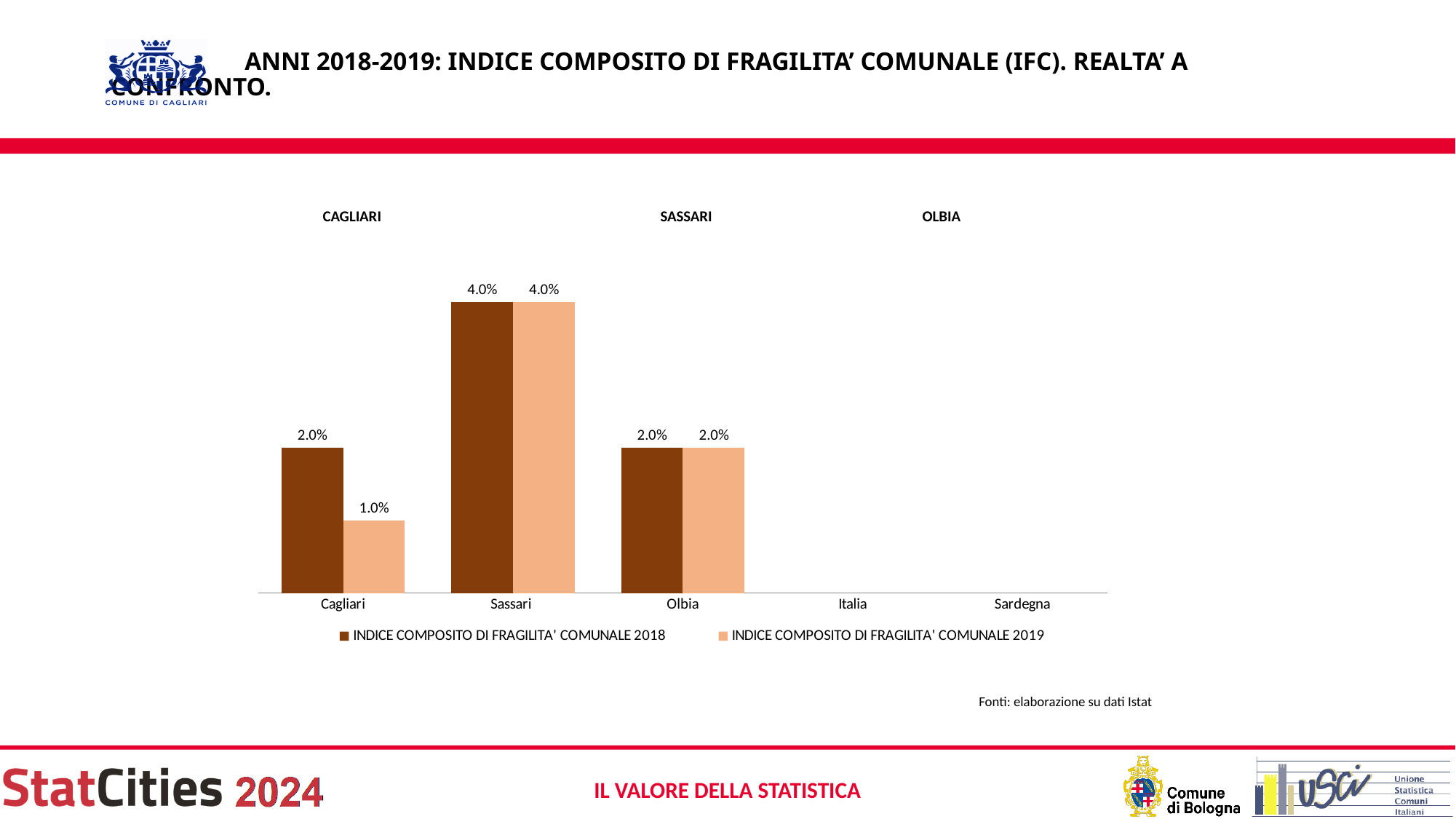
What is the value of INDICE COMPOSITO DI FRAGILITA' COMUNALE 2019 for Sassari? 4.0% What is the value of INDICE COMPOSITO DI FRAGILITA' COMUNALE 2018 for Cagliari? 2.0% How many series does the legend list? 2 Which city has the lowest value for INDICE COMPOSITO DI FRAGILITA' COMUNALE 2019? Cagliari What is the value of INDICE COMPOSITO DI FRAGILITA' COMUNALE 2018 for Olbia? 2.0% Which is larger: the 2019 value for Sassari or the 2019 value for Olbia? Sassari What is the difference between the 2018 values for Sassari and Olbia? 2.0% How many categories are shown on the x axis of the chart? 5 Which city has the highest value for INDICE COMPOSITO DI FRAGILITA' COMUNALE 2018? Sassari What is the difference between the 2018 and 2019 values for Cagliari? 1.0% What is the value of INDICE COMPOSITO DI FRAGILITA' COMUNALE 2019 for Cagliari? 1.0% What kind of chart is shown on the slide? Bar chart